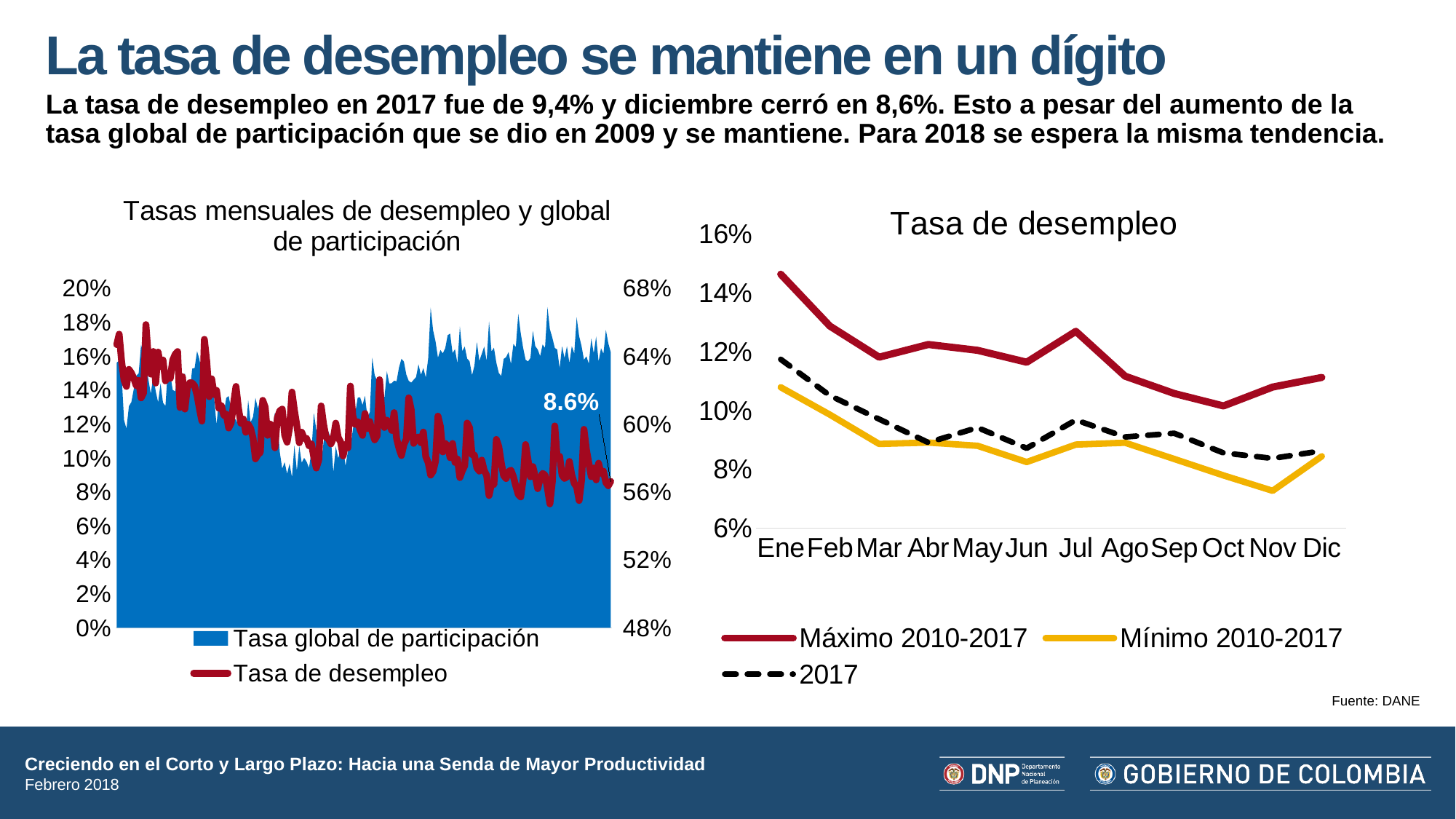
On the right chart titled 'Tasa de desempleo', in which month is the 'Mínimo 2010-2017' series lowest? Nov On the left chart titled 'Tasas mensuales de desempleo y global de participación', how many series does the legend list? 2 On the right chart titled 'Tasa de desempleo', is the '2017' value for Dic greater or less than 10%? less On the right chart titled 'Tasa de desempleo', does the 'Máximo 2010-2017' series rise or fall from Ene to Mar? fall On the right chart titled 'Tasa de desempleo', how many months are shown on the x axis? 12 What kind of chart is the right chart titled 'Tasa de desempleo'? line chart On the right chart titled 'Tasa de desempleo', is the 'Mínimo 2010-2017' value for Nov greater or less than 8%? less On the left chart titled 'Tasas mensuales de desempleo y global de participación', what value is labelled at the end of the 'Tasa de desempleo' line? 8.6% On the right chart titled 'Tasa de desempleo', how many series does the legend list? 3 On the right chart titled 'Tasa de desempleo', in which month is the 'Máximo 2010-2017' series highest? Ene On the right chart titled 'Tasa de desempleo', is the 'Máximo 2010-2017' value for Ene greater or less than 14%? greater On the right chart titled 'Tasa de desempleo', which is larger in Jul: the 'Máximo 2010-2017' value or the 'Mínimo 2010-2017' value? Máximo 2010-2017